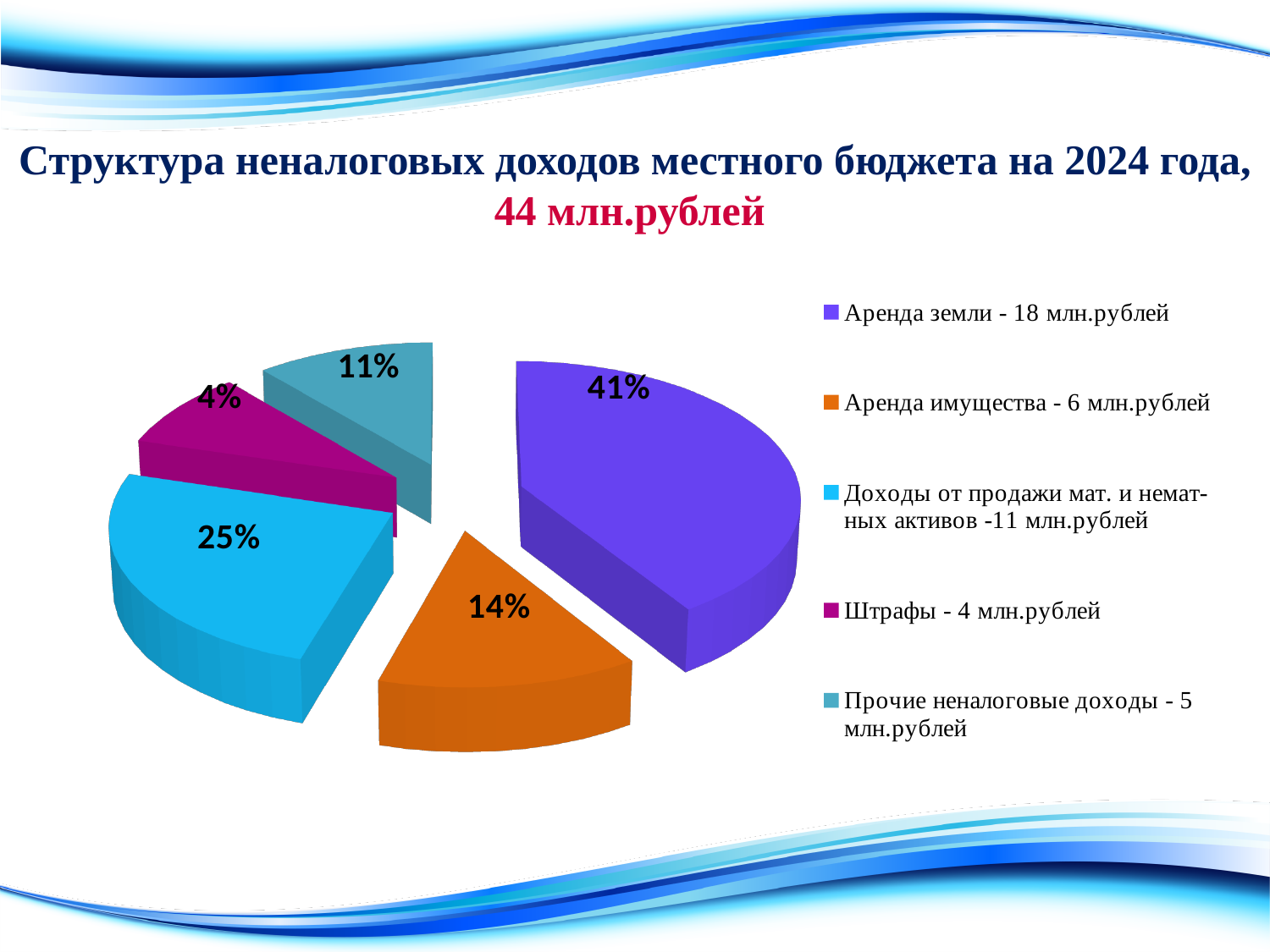
According to the legend, how many million rubles does "Аренда земли" amount to? 18 млн.рублей What total amount in million rubles is stated in the chart title? 44 млн.рублей Which has a larger share: "Аренда имущества" or "Прочие неналоговые доходы"? Аренда имущества What kind of chart is shown on the slide? Pie chart How many slices does the pie chart have? 5 What percentage share does the slice for "Аренда земли" have? 41% Which category has the largest share of the pie? Аренда земли What is the difference in percentage points between the shares of "Аренда земли" and "Доходы от продажи мат. и немат-ных активов"? 16 What percentage share does the slice for "Аренда имущества" have? 14% What percentage share does the slice for "Штрафы" have? 4% What percentage share does the slice for "Прочие неналоговые доходы" have? 11% Which category has the smallest share of the pie? Штрафы